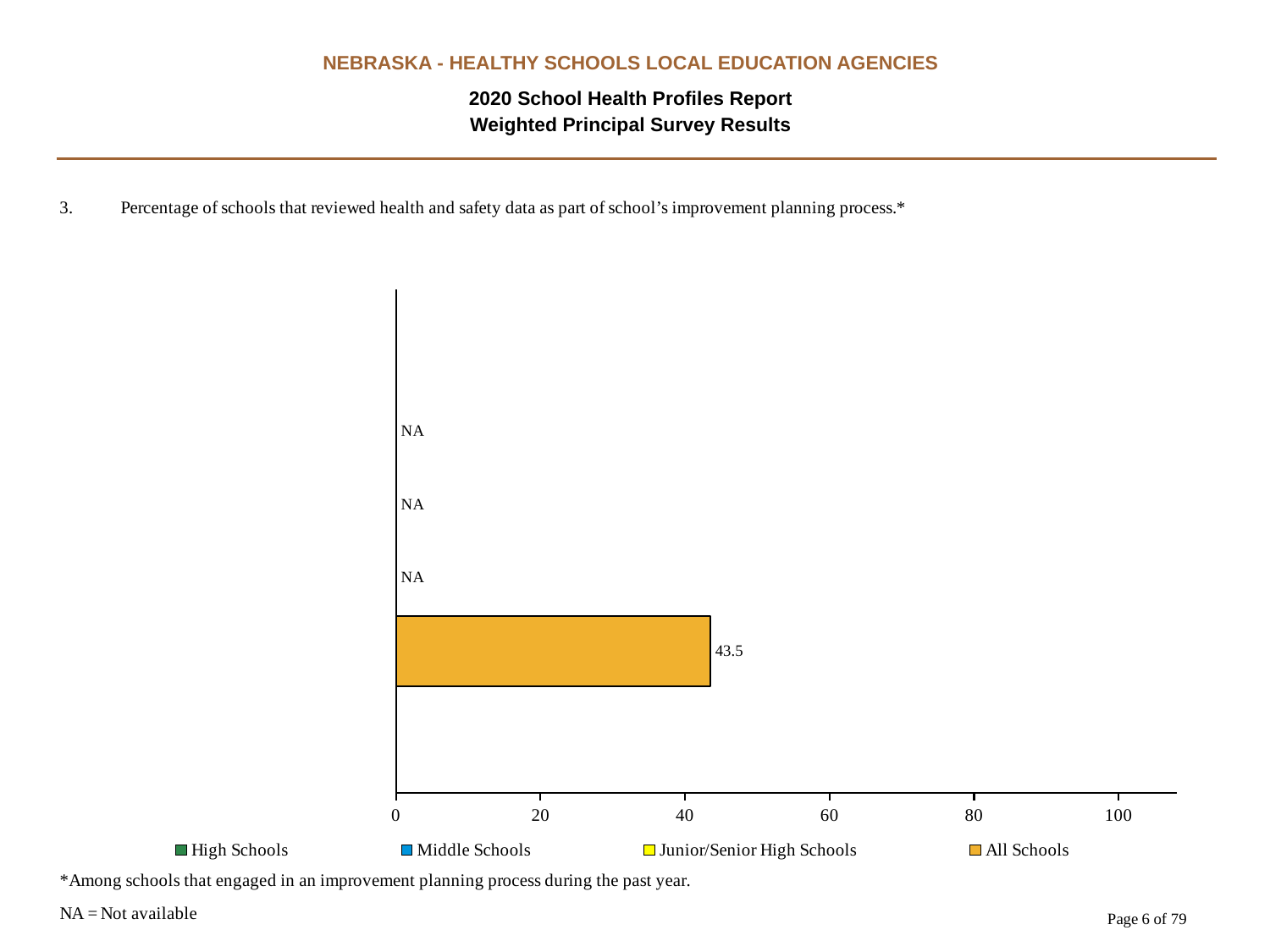
What is the highest value shown on the x axis? 100 What does NA stand for according to the slide? Not available Is the value for All Schools greater or less than 40? greater What is shown for Junior/Senior High Schools? NA Is the value for All Schools greater or less than 60? less What is shown for Middle Schools? NA What is the value for All Schools? 43.5 What is shown for High Schools? NA What kind of chart is shown? Bar chart How many series have a plotted bar with a numeric value? 1 How many series does the legend list? 4